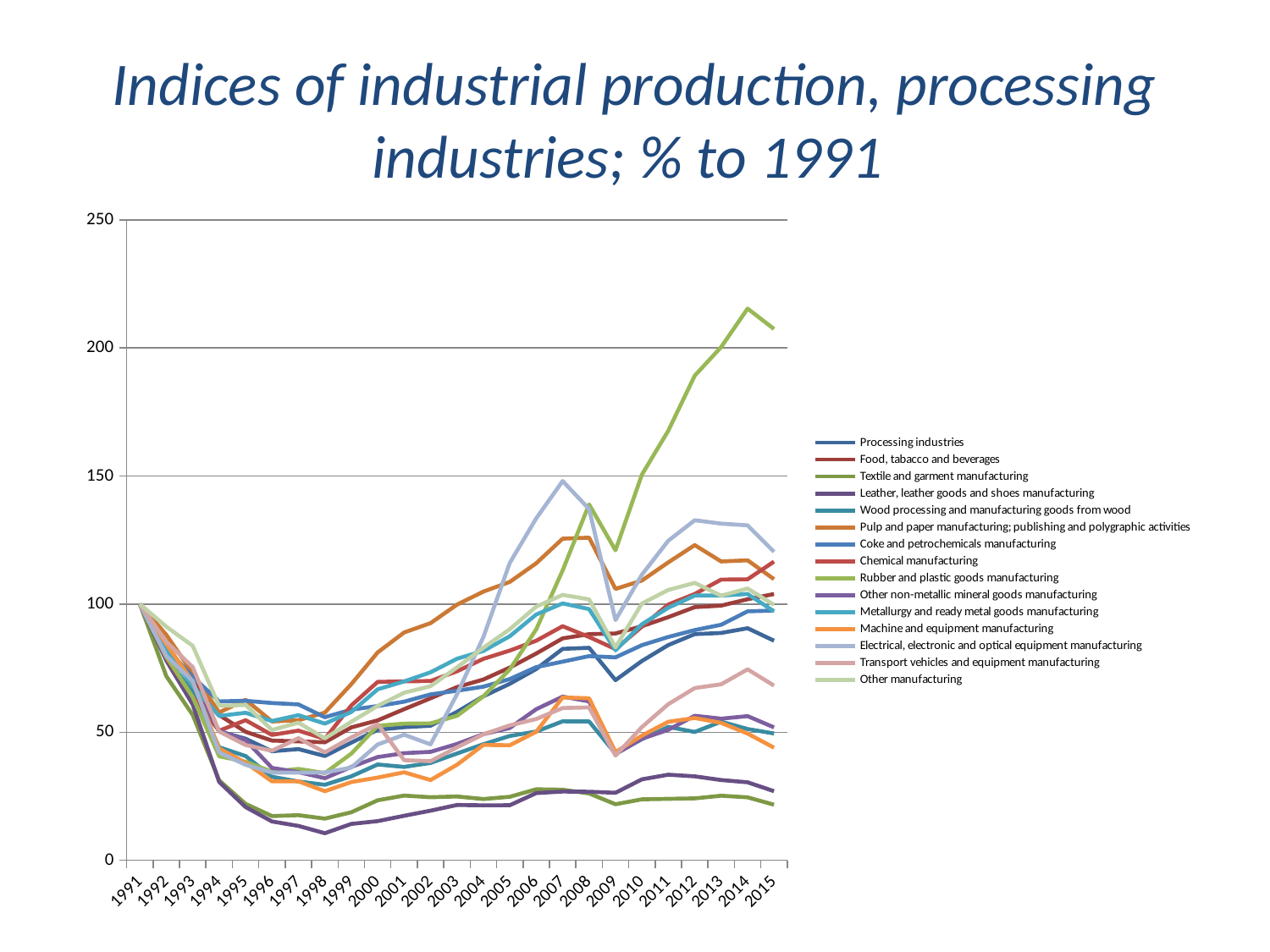
What is the title of the chart? Indices of industrial production, processing industries; % to 1991 Which series has the lowest value in 1998? Leather, leather goods and shoes manufacturing What is the value of every series in 1991? 100 Is the value for Electrical, electronic and optical equipment manufacturing in 2007 greater or less than 100? greater Which series reaches the highest value anywhere on the chart? Rubber and plastic goods manufacturing In 2015, which is larger: Rubber and plastic goods manufacturing or Processing industries? Rubber and plastic goods manufacturing How many years are plotted along the x axis? 25 What kind of chart is shown on the slide? line chart Is the value for Textile and garment manufacturing in 2015 greater or less than 50? less Does the Rubber and plastic goods manufacturing line rise or fall between 2009 and 2014? rise How many series does the legend list? 15 Is the value for Rubber and plastic goods manufacturing in 2014 greater or less than 200? greater